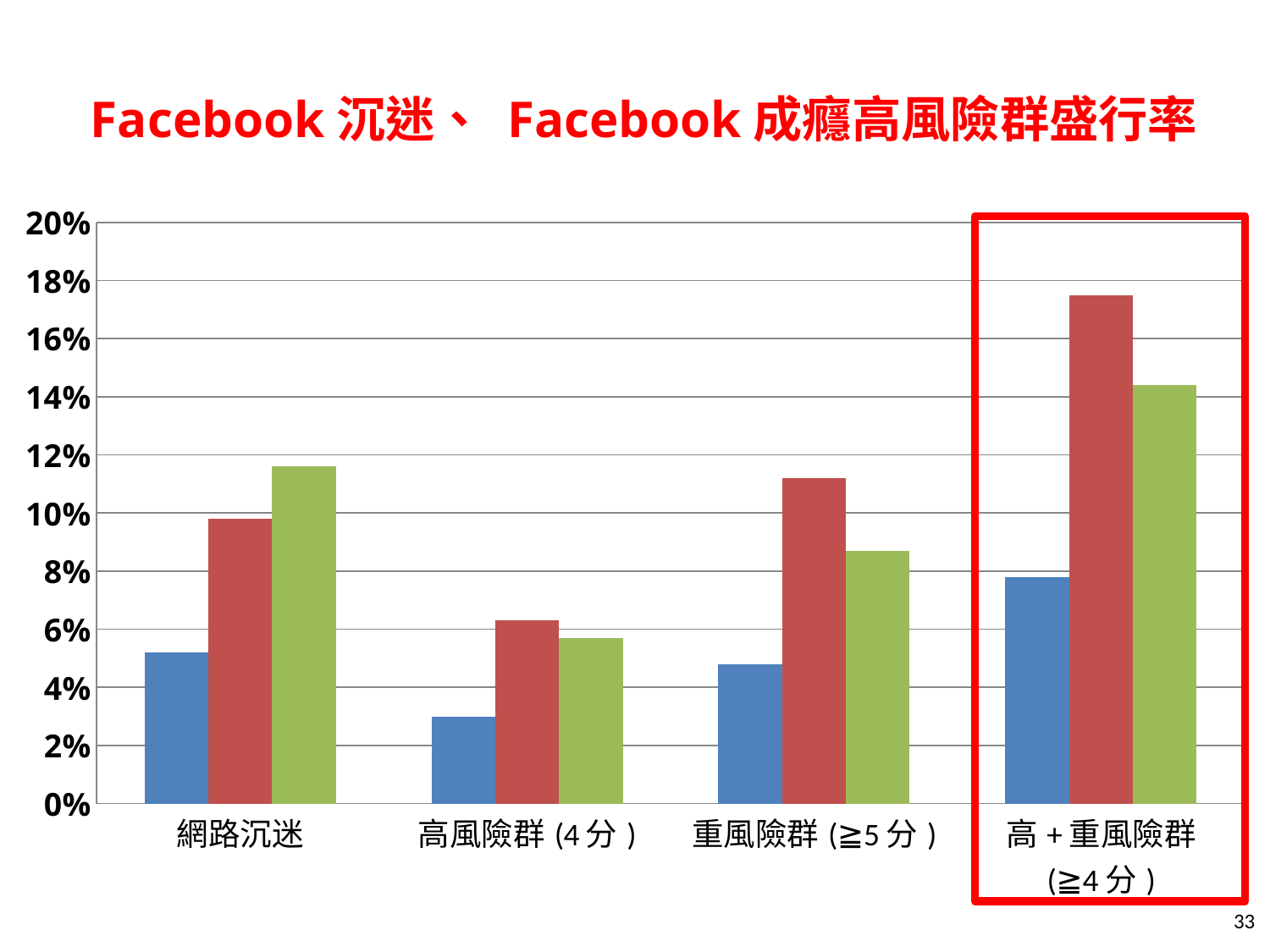
Which category on the chart is highlighted with a red box? 高＋重風險群 (≧4分) Is the blue bar for 高風險群 (4分) greater or less than 4%? less Which category has the lowest blue bar? 高風險群 (4分) What kind of chart is shown on the slide? bar chart How many bars are plotted for each category in the chart? 3 For 網路沉迷, which bar is taller, the red bar or the green bar? green bar How many categories are shown on the x axis of the chart? 4 Which category contains the tallest bar in the chart? 高＋重風險群 (≧4分) Is the green bar for 網路沉迷 greater or less than 10%? greater Is the red bar for 重風險群 (≧5分) greater or less than 10%? greater For 重風險群 (≧5分), which bar is taller, the red bar or the green bar? red bar